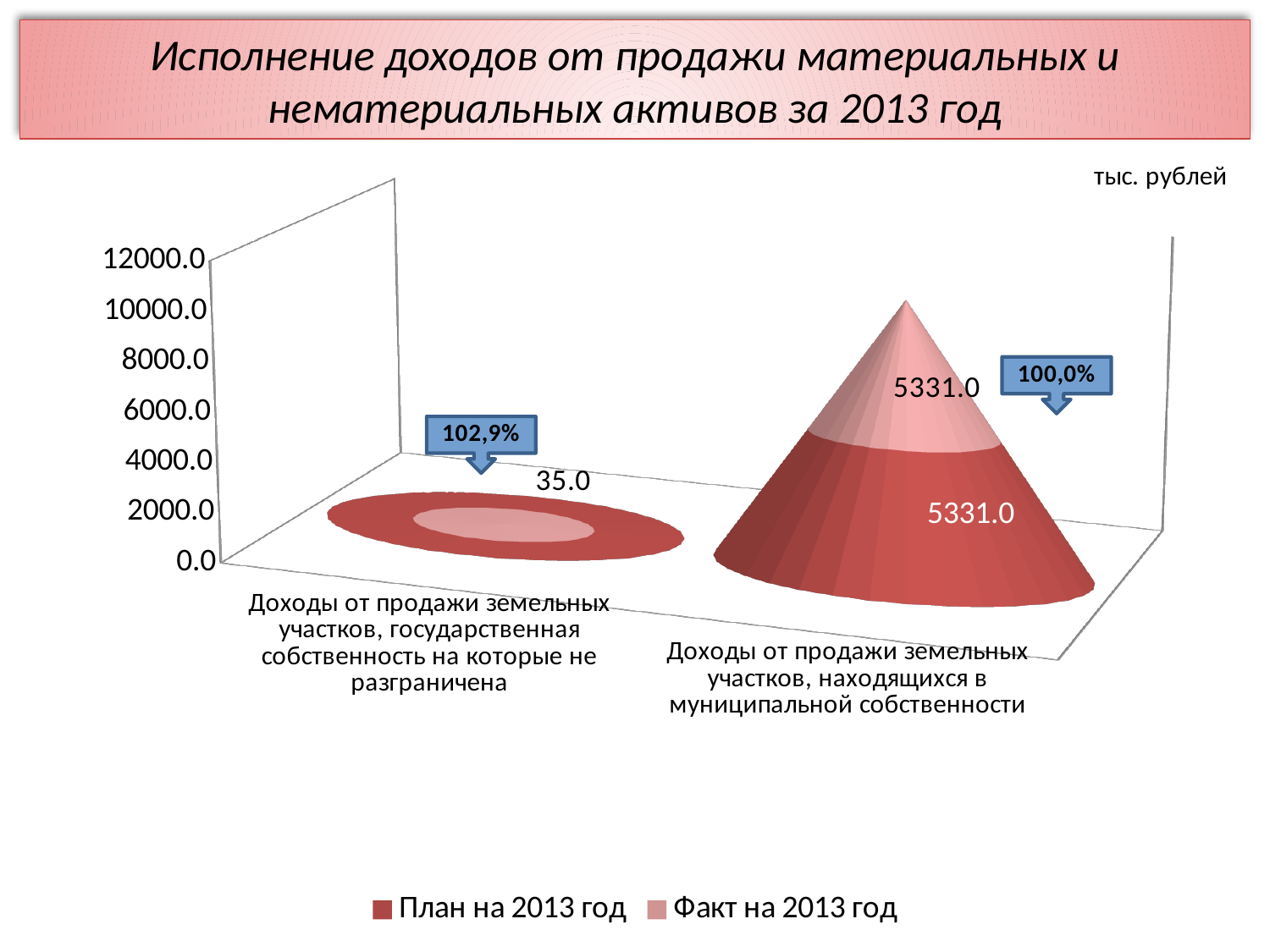
What is the difference between the 'План на 2013 год' and 'Факт на 2013 год' values for 'Доходы от продажи земельных участков, находящихся в муниципальной собственности'? 0.0 What percentage is shown in the callout above the category 'Доходы от продажи земельных участков, государственная собственность на которые не разграничена'? 102,9% How many categories are shown on the x axis? 2 Which category has the higher 'План на 2013 год' value? Доходы от продажи земельных участков, находящихся в муниципальной собственности What is the value of 'План на 2013 год' for 'Доходы от продажи земельных участков, находящихся в муниципальной собственности'? 5331.0 What percentage is shown in the callout above the category 'Доходы от продажи земельных участков, находящихся в муниципальной собственности'? 100,0% What unit is indicated in the top-right corner of the chart? тыс. рублей What is the combined total of the stacked 'План на 2013 год' and 'Факт на 2013 год' values for 'Доходы от продажи земельных участков, находящихся в муниципальной собственности'? 10662.0 What are the two legend entries of the chart? План на 2013 год; Факт на 2013 год How many series does the legend list? 2 What data label is printed for the category 'Доходы от продажи земельных участков, государственная собственность на которые не разграничена'? 35.0 What is the value of 'Факт на 2013 год' for 'Доходы от продажи земельных участков, находящихся в муниципальной собственности'? 5331.0